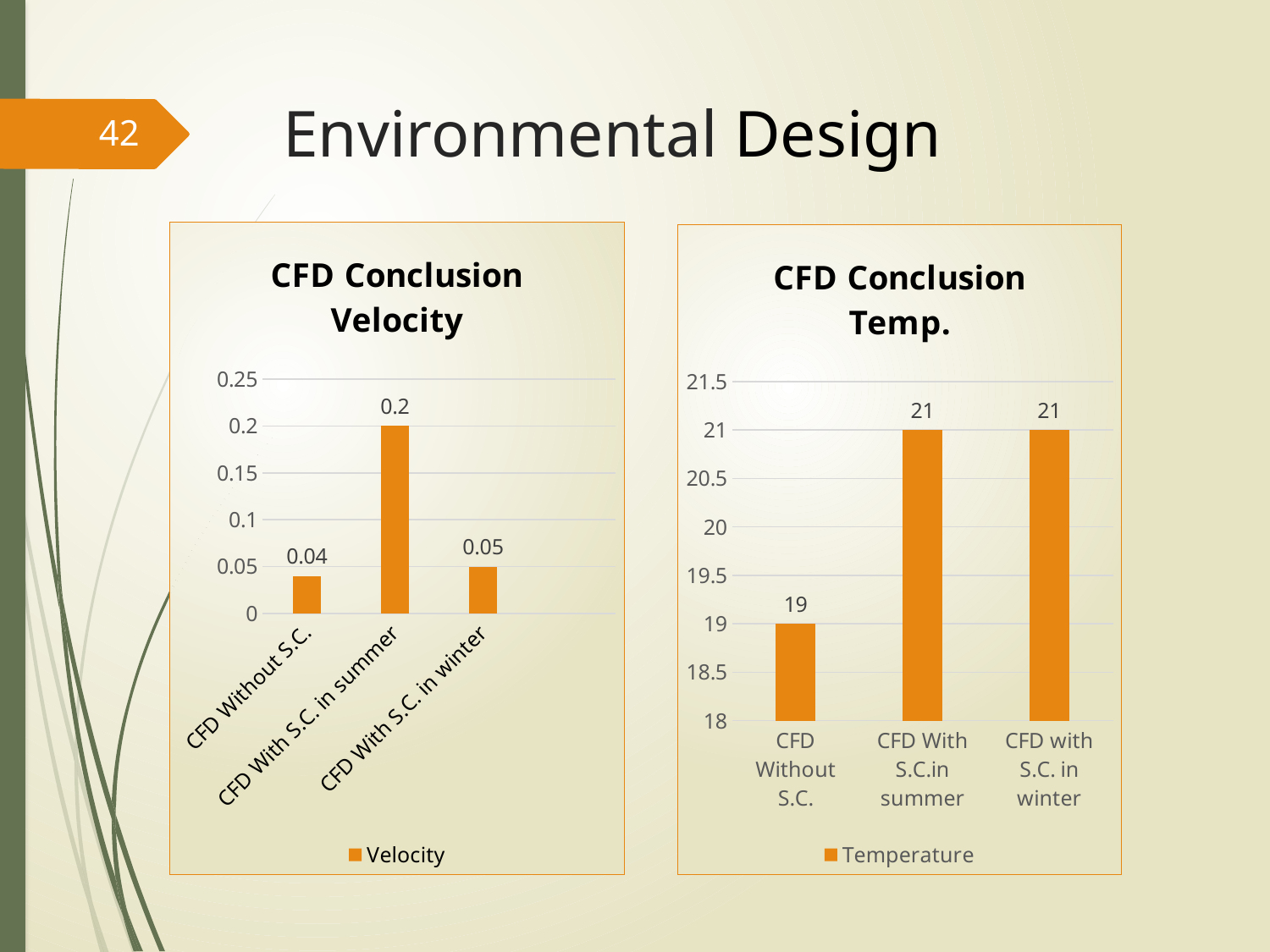
In the 'CFD Conclusion Temp.' chart, what is the temperature value for 'CFD with S.C. in winter'? 21 In the 'CFD Conclusion Velocity' chart, which category has the lowest velocity? CFD Without S.C. In the 'CFD Conclusion Velocity' chart, what is the velocity value for 'CFD Without S.C.'? 0.04 In the 'CFD Conclusion Temp.' chart, which category has the lowest temperature? CFD Without S.C. In the 'CFD Conclusion Velocity' chart, which category has the highest velocity? CFD With S.C. in summer In the 'CFD Conclusion Temp.' chart, what is the difference between the temperature for 'CFD With S.C.in summer' and 'CFD Without S.C.'? 2 What series name does the legend of the 'CFD Conclusion Velocity' chart list? Velocity In the 'CFD Conclusion Velocity' chart, how many categories are plotted? 3 In the 'CFD Conclusion Velocity' chart, what is the velocity value for 'CFD With S.C. in summer'? 0.2 What kind of chart is the 'CFD Conclusion Temp.' chart? Bar chart In the 'CFD Conclusion Velocity' chart, what is the difference between the velocity for 'CFD With S.C. in summer' and 'CFD With S.C. in winter'? 0.15 In the 'CFD Conclusion Temp.' chart, what is the temperature value for 'CFD Without S.C.'? 19